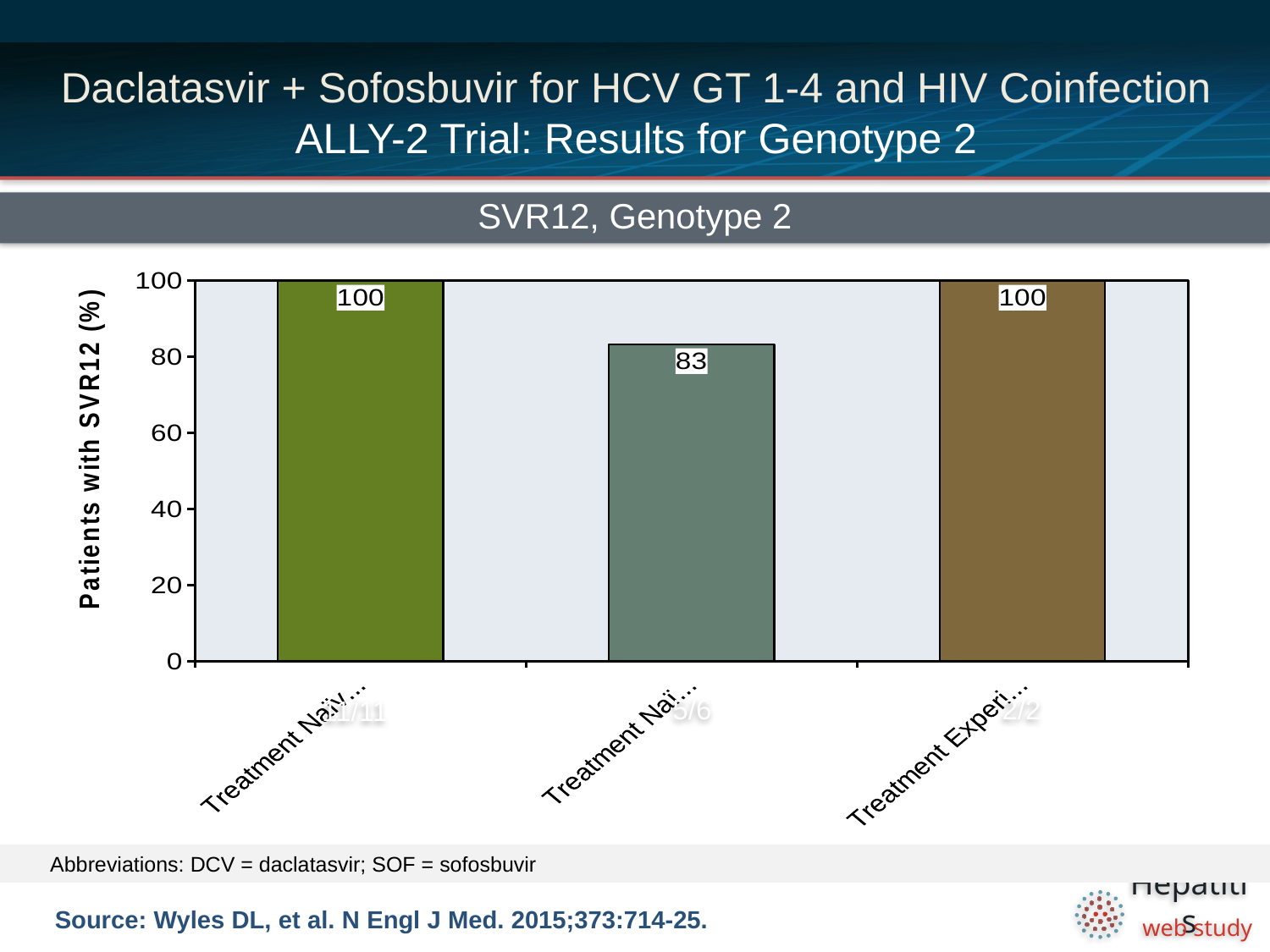
How many bars are plotted in the chart? 3 What is the value of the middle bar in the chart? 83 Is the value of the middle bar greater or less than 80? greater Which bar has the lowest value: the left, middle, or right bar? middle What is the value of the rightmost bar in the chart? 100 What kind of chart is shown on the slide? bar chart What is the value of the leftmost bar in the chart? 100 What is the title of the chart? SVR12, Genotype 2 How many bars in the chart reach a value of 100? 2 What is the difference between the value of the leftmost bar and the middle bar? 17 Which is larger, the value of the leftmost bar or the middle bar? leftmost bar What is the label on the y-axis of the chart? Patients with SVR12 (%)